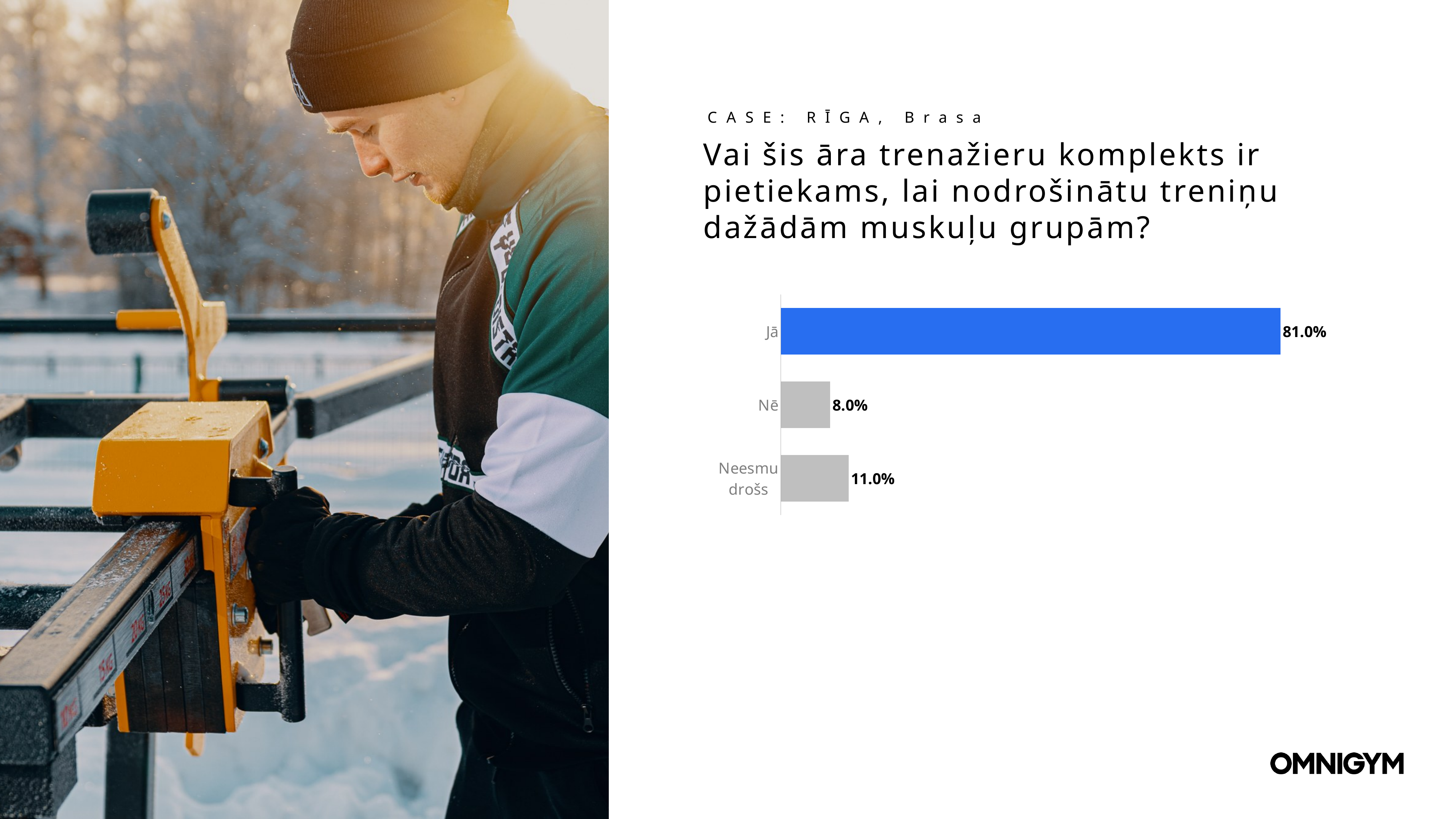
What is the value for Jā? 81.0% What is the value for Nē? 8.0% What is the difference between the values for Neesmu drošs and Nē? 3.0% How many categories are shown in the chart? 3 What colour is the bar for Jā? Blue What is the total of the three values shown in the chart? 100.0% What kind of chart is shown on the slide? Bar chart Which category has the lowest value? Nē Which is larger, the value for Neesmu drošs or the value for Nē? Neesmu drošs What is the value for Neesmu drošs? 11.0% What is the difference between the values for Jā and Nē? 73.0% Which category has the highest value? Jā